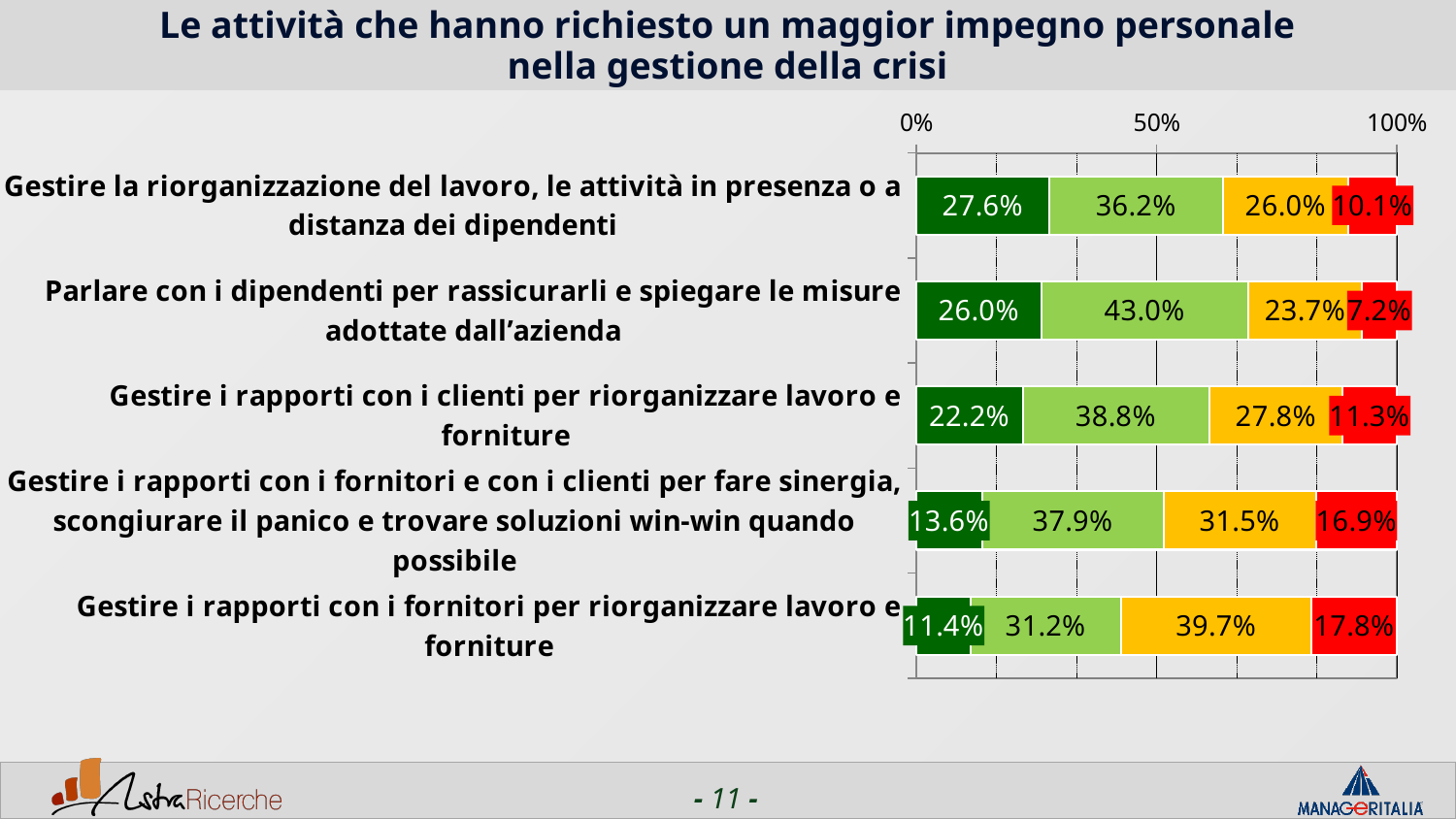
Which activity has the highest dark green segment value? Gestire la riorganizzazione del lavoro, le attività in presenza o a distanza dei dipendenti (27.6%) Which activity has the highest light green segment value? Parlare con i dipendenti per rassicurarli e spiegare le misure adottate dall'azienda (43.0%) How many coloured segments make up each bar in the chart? 4 What is the value of the red segment for 'Gestire i rapporti con i fornitori per riorganizzare lavoro e forniture'? 17.8% What type of chart is shown on the slide? Stacked bar chart Which activity has the lowest dark green segment value? Gestire i rapporti con i fornitori per riorganizzare lavoro e forniture (11.4%) How many activities (categories) are listed in the chart? 5 What is the difference between the light green segment values for 'Parlare con i dipendenti per rassicurarli e spiegare le misure adottate dall'azienda' and 'Gestire la riorganizzazione del lavoro, le attività in presenza o a distanza dei dipendenti'? 6.8 percentage points What is the value of the dark green segment for 'Parlare con i dipendenti per rassicurarli e spiegare le misure adottate dall'azienda'? 26.0% What is the value of the yellow segment for 'Gestire i rapporti con i fornitori e con i clienti per fare sinergia, scongiurare il panico e trovare soluzioni win-win quando possibile'? 31.5% Which has the larger yellow segment value: 'Gestire i rapporti con i fornitori per riorganizzare lavoro e forniture' or 'Gestire i rapporti con i clienti per riorganizzare lavoro e forniture'? Gestire i rapporti con i fornitori per riorganizzare lavoro e forniture (39.7%) Which activity has the lowest red segment value? Parlare con i dipendenti per rassicurarli e spiegare le misure adottate dall'azienda (7.2%)